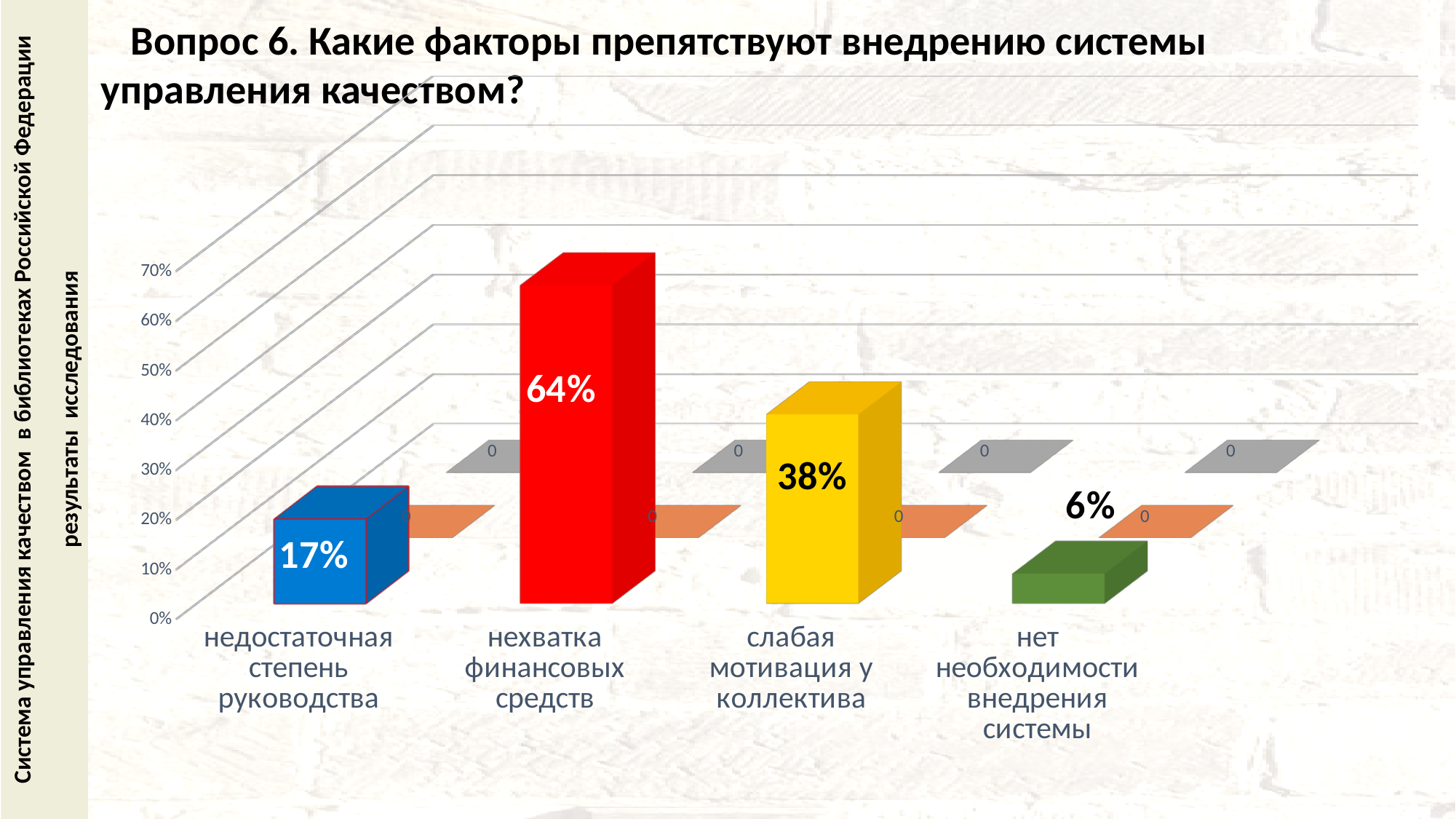
What colour is the bar for «нехватка финансовых средств»? red What is the difference between the values for «нехватка финансовых средств» and «слабая мотивация у коллектива»? 26% Which factor has the highest value? нехватка финансовых средств What is the difference between the values for «недостаточная степень руководства» and «нет необходимости внедрения системы»? 11% What value is shown for «нет необходимости внедрения системы»? 6% Which factor has the lowest value? нет необходимости внедрения системы What value is shown for «нехватка финансовых средств»? 64% What kind of chart is shown on the slide? bar chart What value is shown for «слабая мотивация у коллектива»? 38% What value is shown for «недостаточная степень руководства»? 17% Which is larger: the value for «слабая мотивация у коллектива» or for «недостаточная степень руководства»? слабая мотивация у коллектива How many factor categories are shown on the x axis? 4